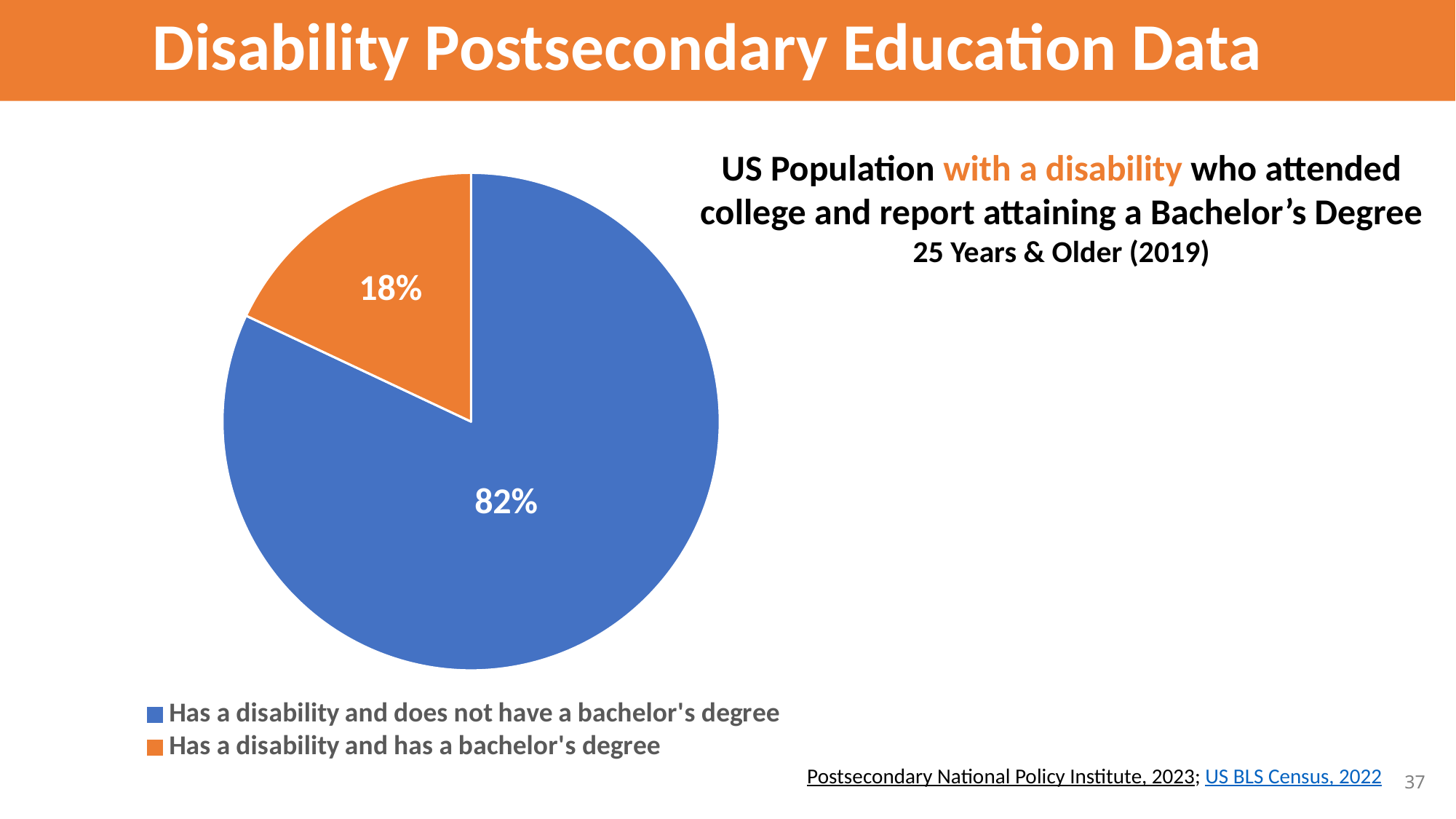
Which category has the largest slice of the pie? Has a disability and does not have a bachelor's degree What kind of chart is shown on the slide? Pie chart What percentage of the pie is labelled for 'Has a disability and does not have a bachelor's degree'? 82% What is the difference in percentage points between the two slices of the pie? 64 How many slices does the pie chart have? 2 What colour is the slice for 'Has a disability and does not have a bachelor's degree'? Blue Which category has the smallest slice of the pie? Has a disability and has a bachelor's degree Which slice is larger: 'Has a disability and has a bachelor's degree' or 'Has a disability and does not have a bachelor's degree'? Has a disability and does not have a bachelor's degree How many entries does the legend list? 2 What percentage of the pie is labelled for 'Has a disability and has a bachelor's degree'? 18% What share of the pie does the orange slice represent? 18% What year is given in the chart's subtitle? 2019